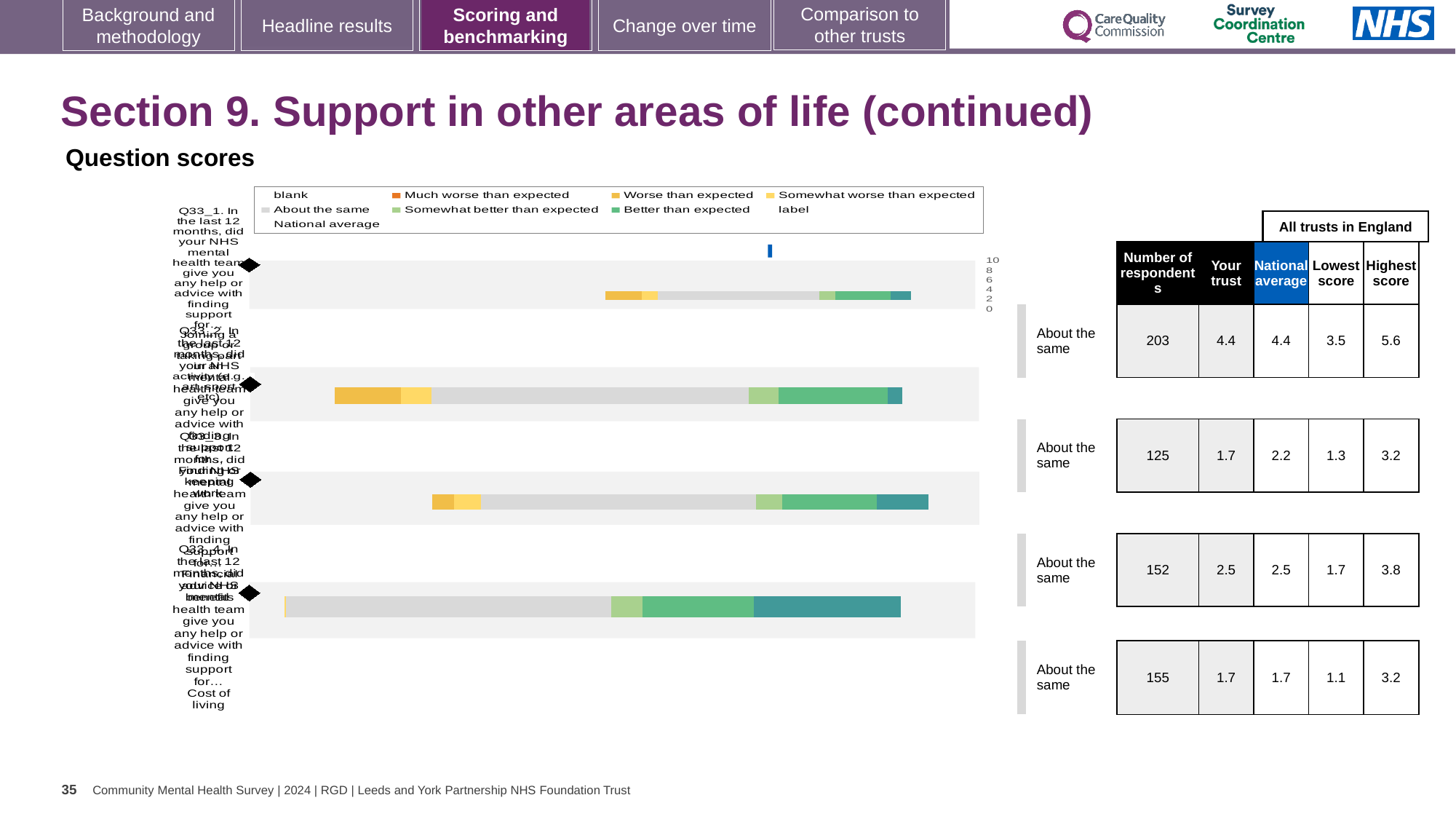
For the first question, what is the difference between the highest score and the lowest score in the table? 2.1 In the table next to the chart, what is the highest score for the third question? 3.8 In the table next to the chart, what is the national average for the fourth (bottom) question? 1.7 Which question row has the highest number of respondents in the table? the first (top) row, 203 What benchmark label is shown beside each of the four question bars? About the same What colour does the legend use for 'Much worse than expected'? orange For the second question, which is larger: the 'Your trust' score or the national average? national average In the table next to the chart, what is the 'Your trust' score for the second question? 1.7 What kind of chart is used to show the question scores on this slide? bar chart How many question bars are plotted in the chart? 4 In the table next to the chart, what is the number of respondents for the first (top) question? 203 Which question row has the lowest number of respondents in the table? the second row, 125